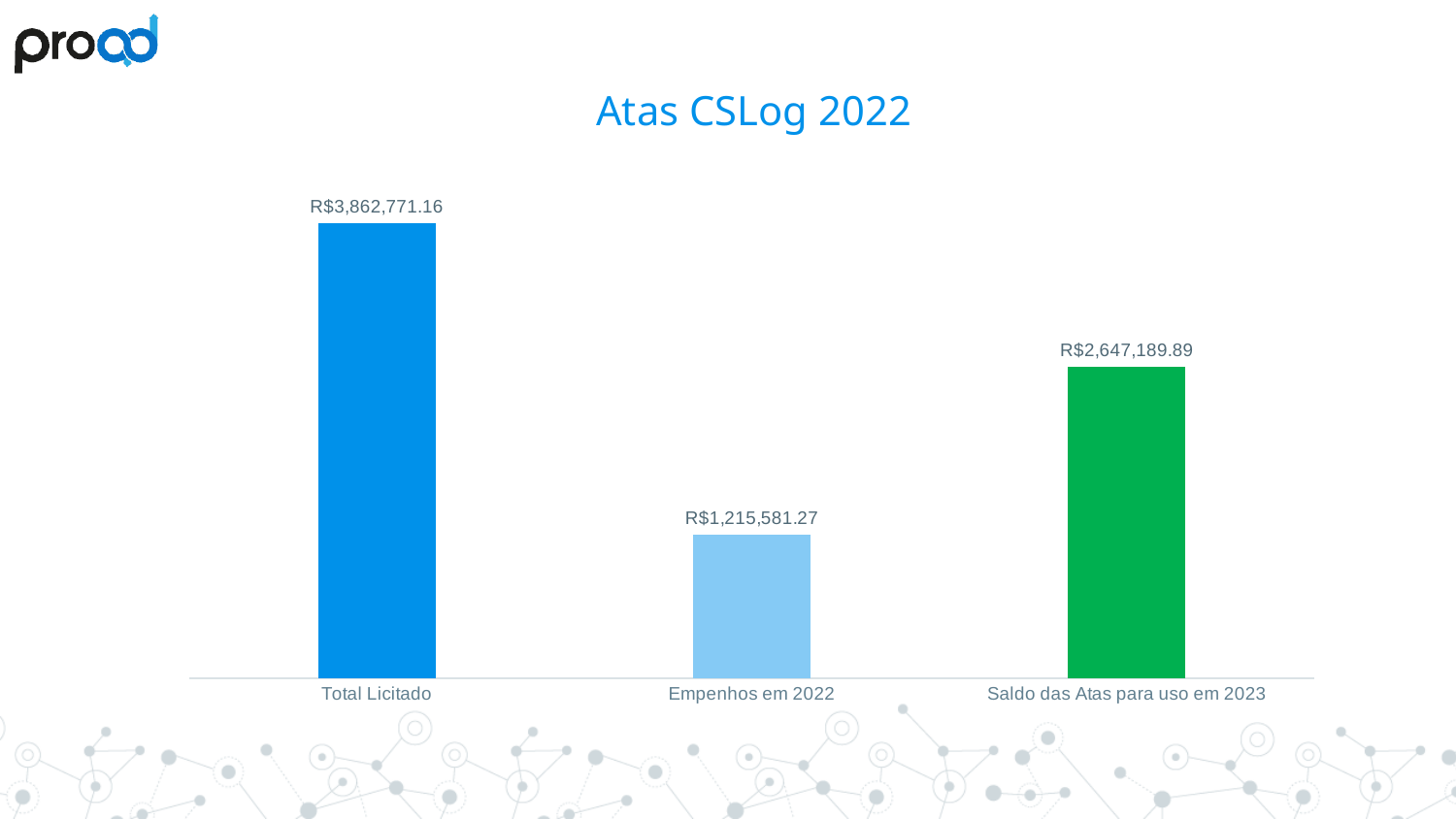
What is the title of the chart? Atas CSLog 2022 What is the difference between Total Licitado and Empenhos em 2022? R$2,647,189.89 What kind of chart is shown on the slide? Bar chart Which category has the lowest value? Empenhos em 2022 Which category has the highest value? Total Licitado What is the difference between Saldo das Atas para uso em 2023 and Empenhos em 2022? R$1,431,608.62 How many categories are shown in the chart? 3 What is the value for Total Licitado? R$3,862,771.16 Which is larger, Empenhos em 2022 or Saldo das Atas para uso em 2023? Saldo das Atas para uso em 2023 What colour is the bar for Saldo das Atas para uso em 2023? Green What is the value for Empenhos em 2022? R$1,215,581.27 What is the value for Saldo das Atas para uso em 2023? R$2,647,189.89